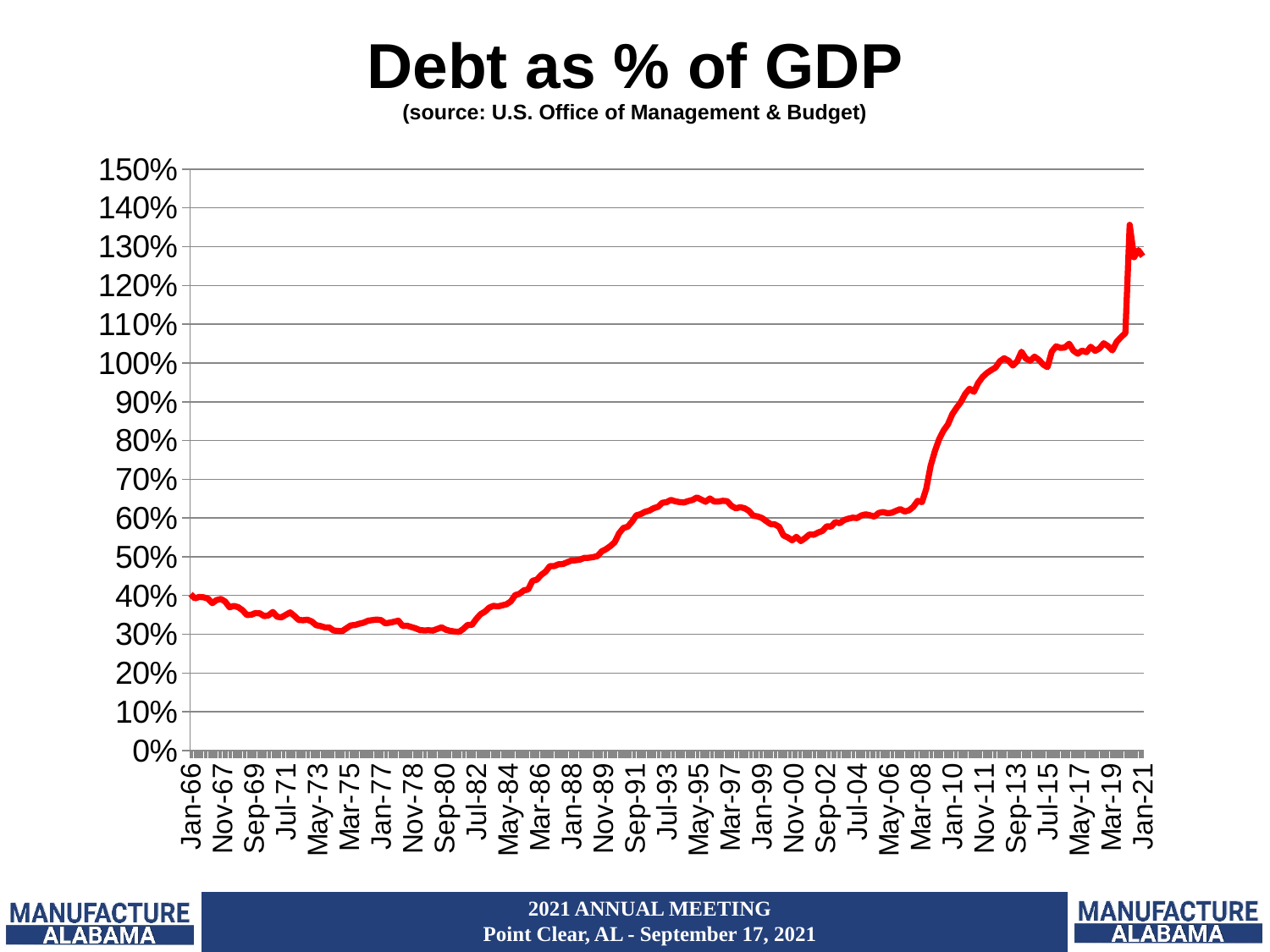
Is the value at Jan-66 greater or less than 50%? less What is the title of the chart? Debt as % of GDP Does the line ever reach 140% on the chart? no What kind of chart is shown on the slide? line chart What colour is the plotted line? red Which is larger, the value at Jan-66 or the value at Jan-21? Jan-21 Is the value at Sep-13 greater or less than 90%? greater Overall, does the debt as % of GDP rise or fall from Jan-66 to Jan-21? rise How many data series are plotted on the chart? 1